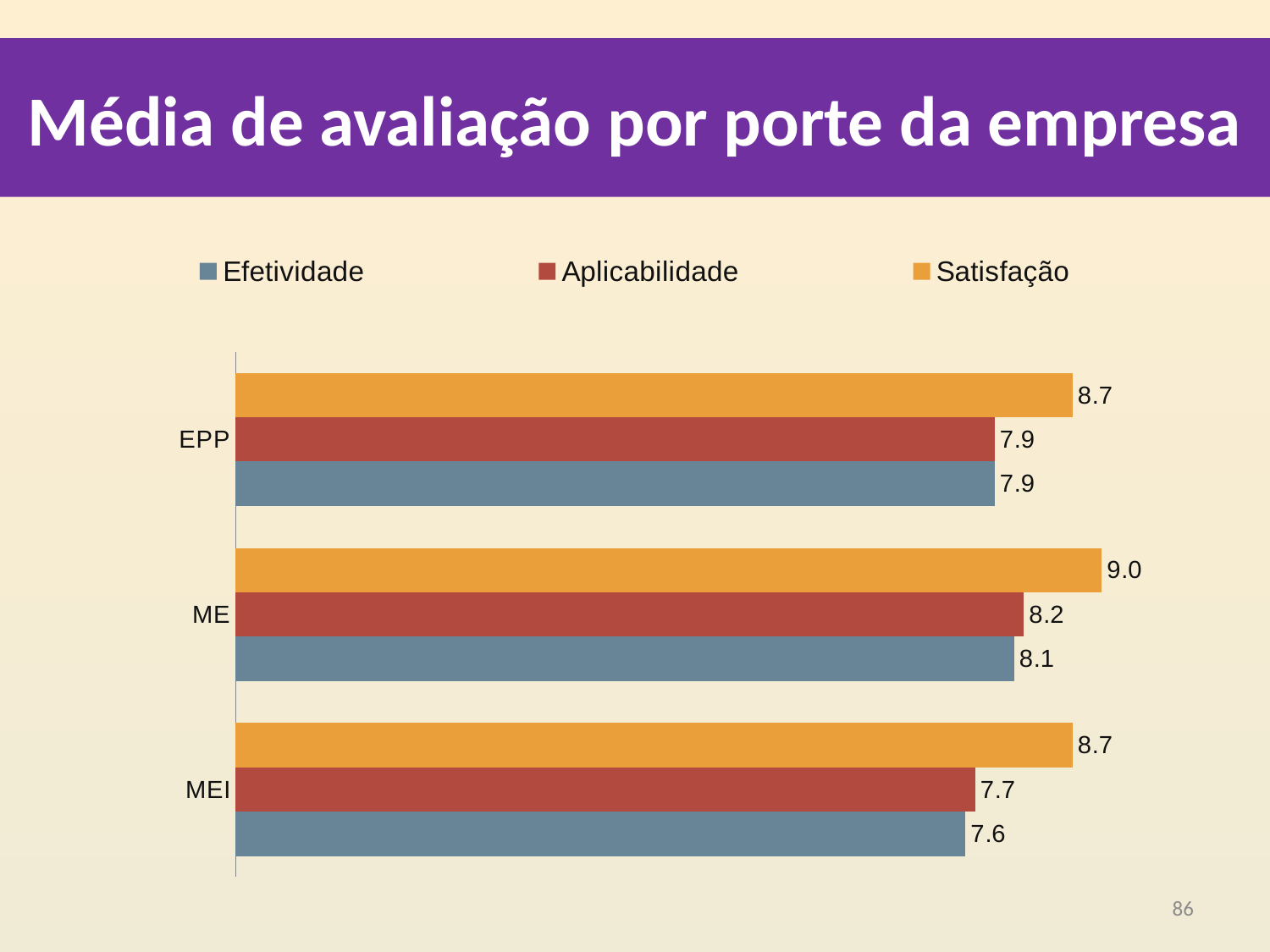
How many series does the legend list? 3 What is the difference between the Satisfação and Efetividade values for MEI? 1.1 Which is larger, the Efetividade value for ME or the Efetividade value for EPP? ME What is the Aplicabilidade value for EPP? 7.9 What kind of chart is shown on the slide? Bar chart What is the Aplicabilidade value for MEI? 7.7 What is the Efetividade value for MEI? 7.6 How many company size categories are shown on the chart? 3 Which company size has the lowest Efetividade value? MEI Which company size has the highest Satisfação value? ME What is the Satisfação value for ME? 9.0 What is the difference between the Satisfação values for ME and EPP? 0.3